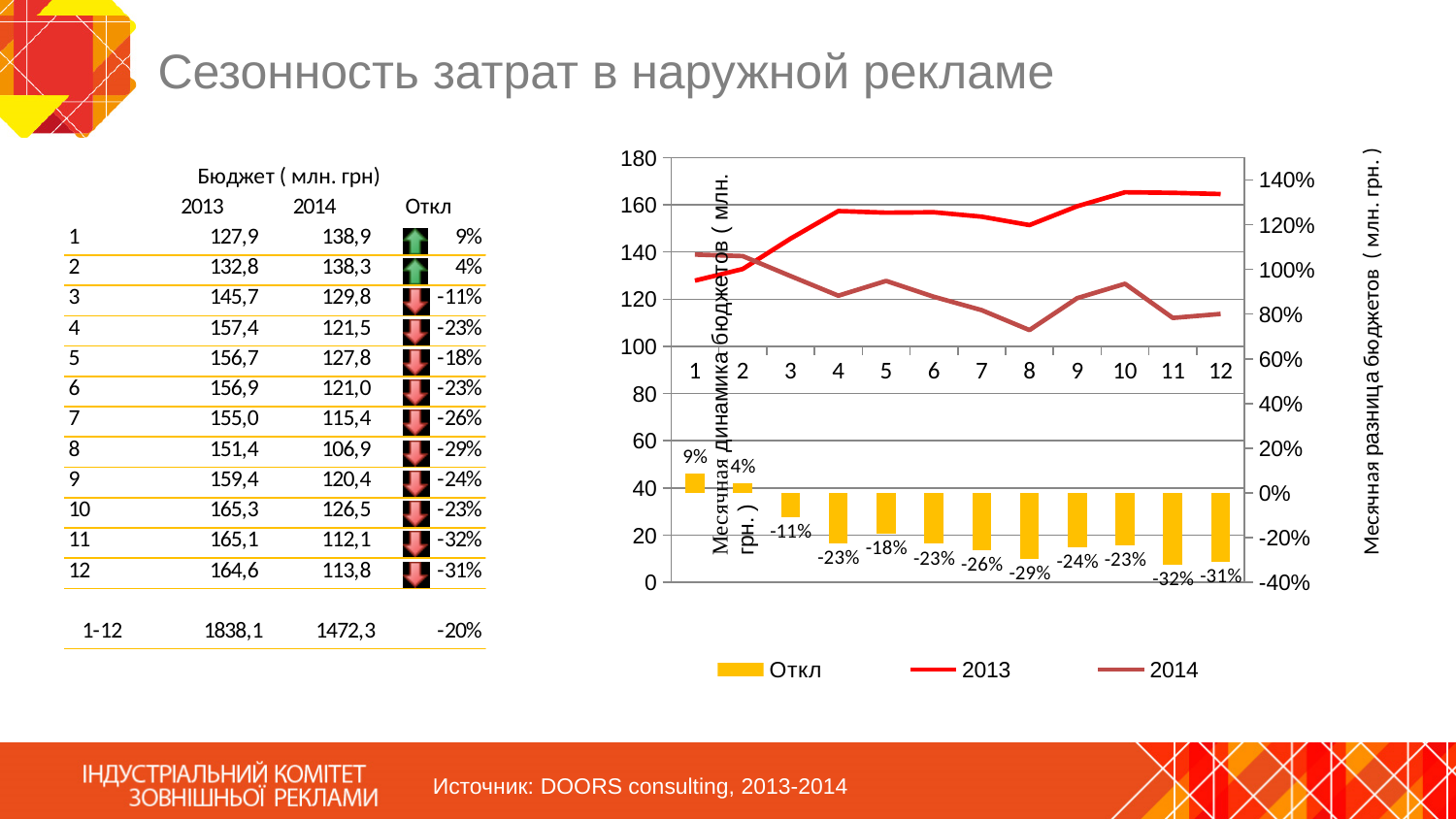
What is the value of the Откл bar for month 11? -32% Does the 2014 line rise or fall from month 1 to month 8? fall What is the value of the Откл bar for month 1? 9% What is the difference between the Откл values for month 1 and month 2? 5 percentage points How many series does the chart legend list? 3 Which month has the highest Откл value? 1 Is the value of the 2014 line at month 8 greater or less than 120? less Which month has the lowest Откл value? 11 Which has the larger Откл value, month 4 or month 5? Month 5 How many months are shown on the x axis of the chart? 12 What is the value of the Откл bar for month 8? -29% Is the value of the 2013 line at month 10 greater or less than 160? greater